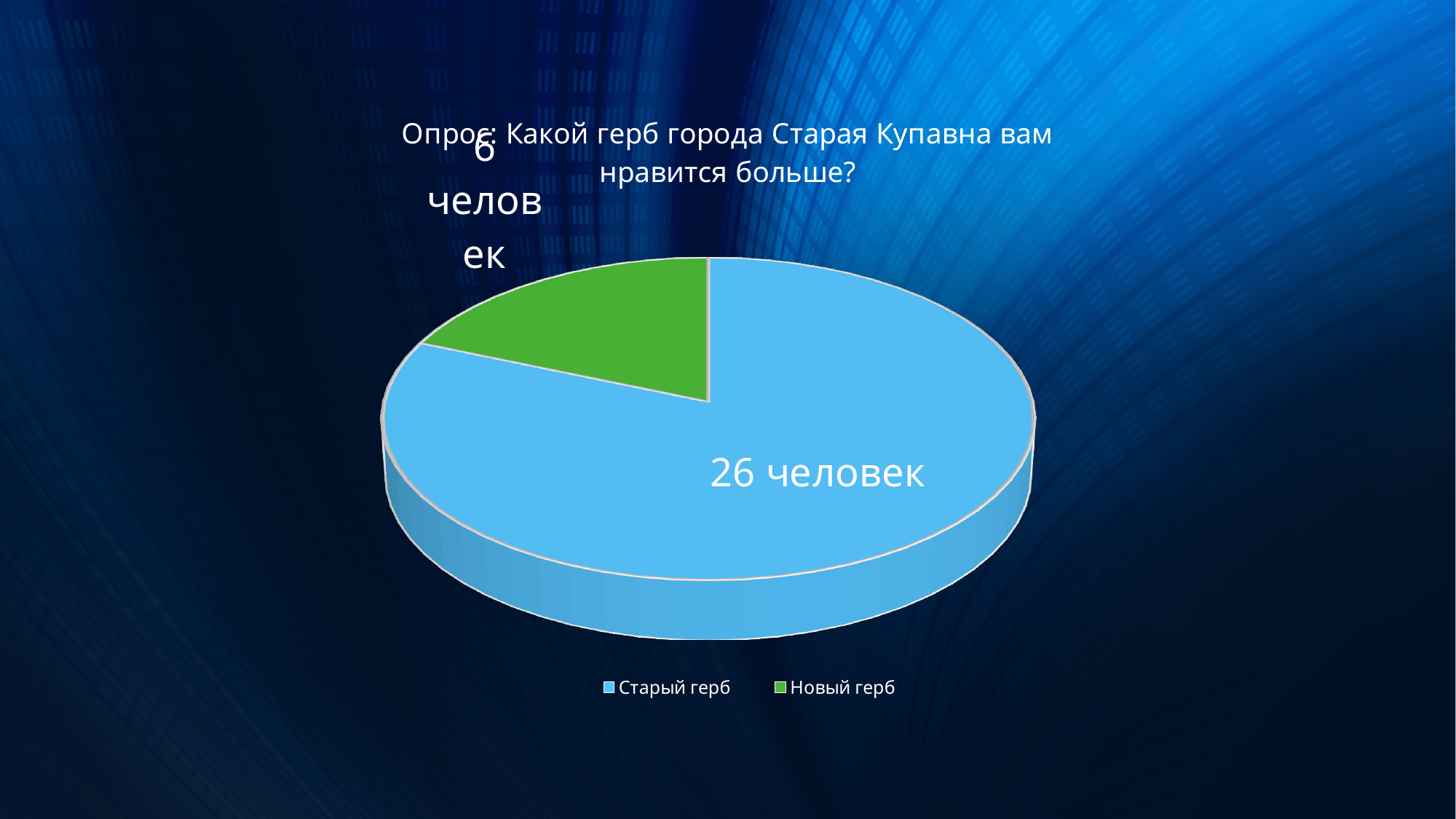
How many people chose Старый герб? 26 человек How many people chose Новый герб? 6 человек What is the title of the chart? Опрос: Какой герб города Старая Купавна вам нравится больше? What colour is the slice for Новый герб? Green Which slice is larger: Старый герб or Новый герб? Старый герб What type of chart is shown on the slide? Pie chart Which option received the most votes? Старый герб How many slices does the pie chart have? 2 Which option received the fewest votes? Новый герб How many entries does the legend list? 2 How many more people chose Старый герб than Новый герб? 20 What is the total number of people surveyed according to the chart? 32